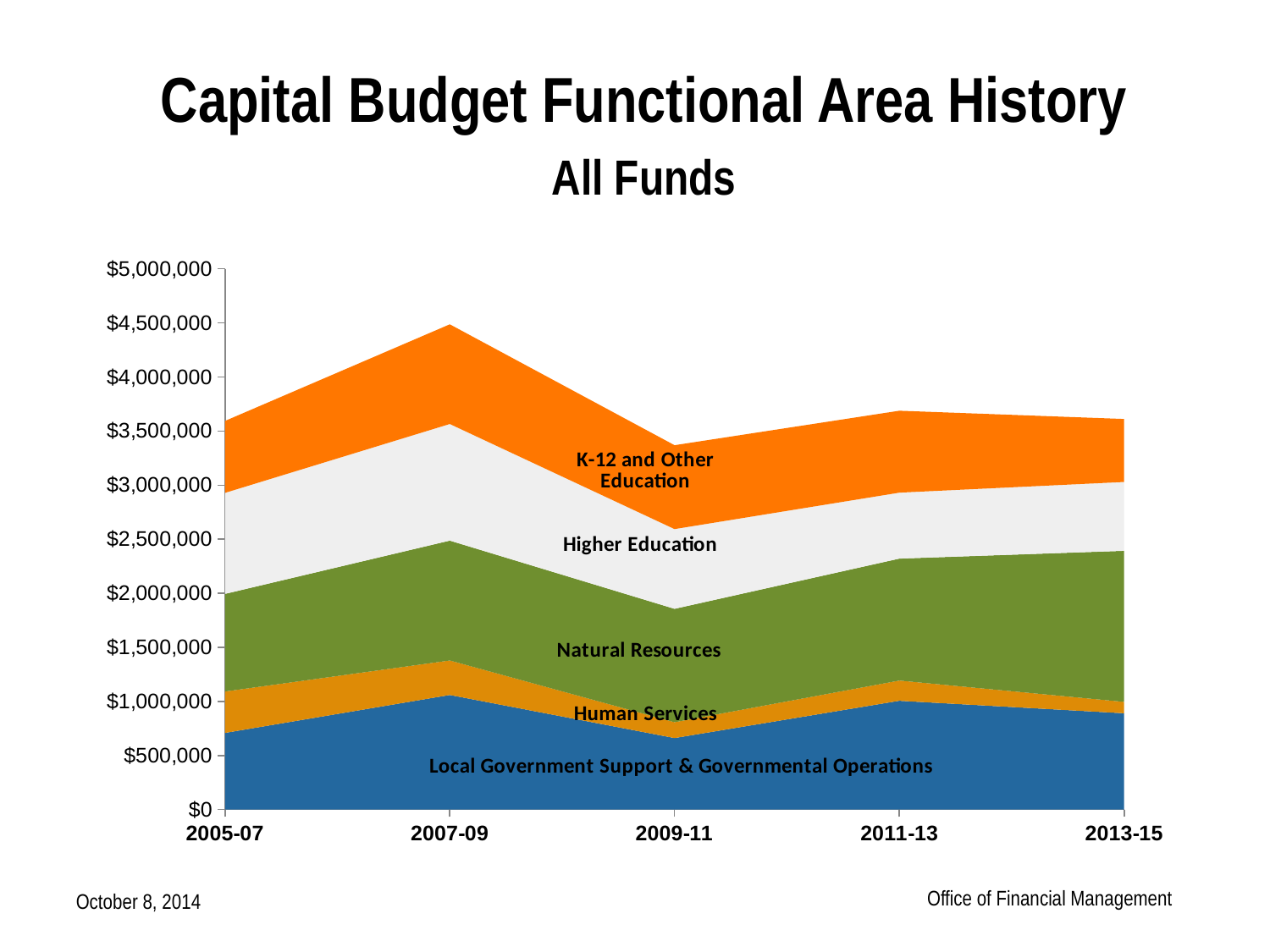
Which functional area is at the bottom of the stacked areas? Local Government Support & Governmental Operations In which period is the total capital budget across all functional areas highest? 2007-09 Does the total capital budget rise or fall from 2007-09 to 2009-11? fall Is the total value for 2009-11 greater or less than $3,000,000? greater What kind of chart is shown on the slide? Stacked area chart How many biennium periods are shown on the x axis? 5 In which period is the total capital budget across all functional areas lowest? 2009-11 How many functional areas are labeled in the chart? 5 Is the total value for 2007-09 greater or less than $4,000,000? greater Which period has a larger total, 2007-09 or 2009-11? 2007-09 What is the highest value shown on the y axis? $5,000,000 Is the value for Local Government Support & Governmental Operations in 2009-11 greater or less than $1,000,000? less